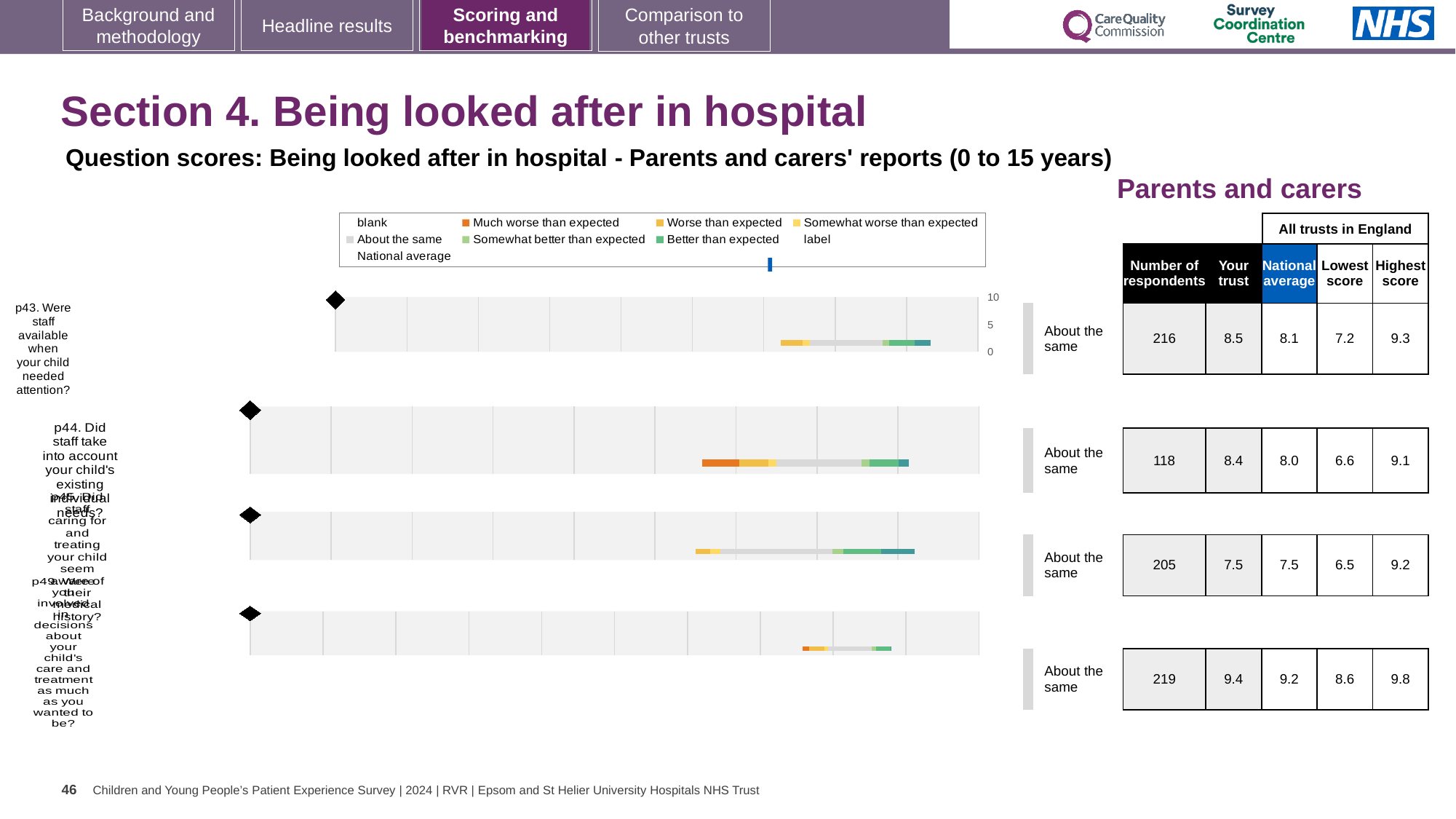
For p44, what is the lowest score among all trusts in England? 6.6 For p43 (Were staff available when your child needed attention?), what is the 'Your trust' score? 8.5 What colour does the legend use for 'Much worse than expected'? Orange For p43 (Were staff available when your child needed attention?), how many respondents are listed? 216 What benchmark category is shown for p43 (Were staff available when your child needed attention?)? About the same For p43 (Were staff available when your child needed attention?), what is the national average score? 8.1 For p43, which is larger: the 'Your trust' score or the national average? Your trust For p44 (Did staff take into account your child's existing individual needs?), what is the 'Your trust' score? 8.4 Which of the four questions has the highest 'Your trust' score? The bottom question (p49), 9.4 What kind of chart is used to show the question scores on this slide? Bar chart How many question charts are shown on the slide? 4 For p43, what is the difference between the highest score and the lowest score across all trusts in England? 2.1